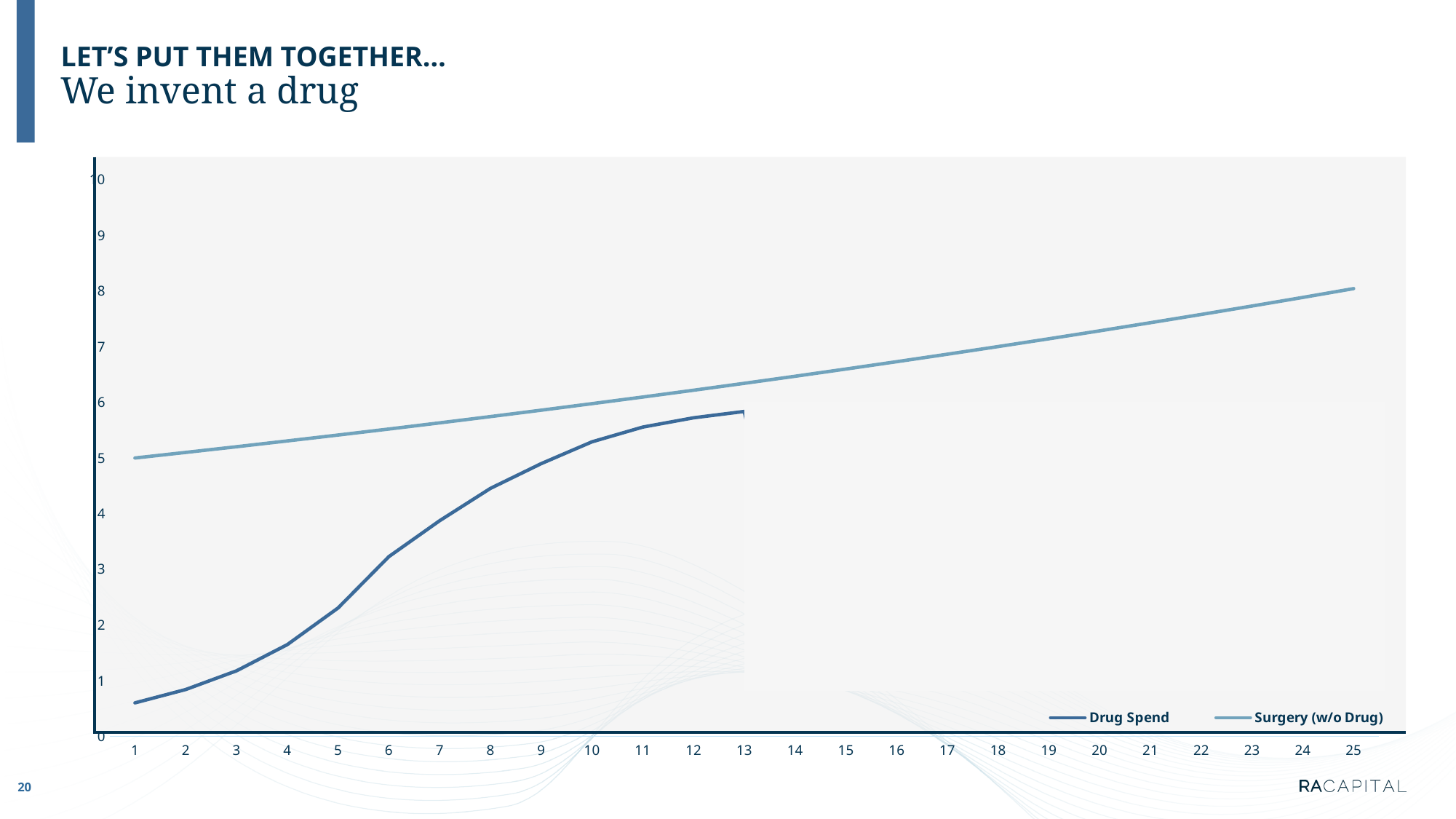
How many series does the legend list? 2 Is the value of Drug Spend at x = 3 greater or less than 2? less Does the Drug Spend line rise or fall from x = 1 to x = 13? rise At x = 5, which series has the higher value, Drug Spend or Surgery (w/o Drug)? Surgery (w/o Drug) How many points are labelled along the x axis? 25 Is the value of Surgery (w/o Drug) at x = 25 greater or less than 7? greater Is the value of Drug Spend at x = 13 greater or less than 6? less Which series is drawn in the darker blue line? Drug Spend What kind of chart is shown on the slide? line chart What are the two series named in the legend? Drug Spend and Surgery (w/o Drug) Does the Surgery (w/o Drug) line rise or fall from x = 1 to x = 25? rise